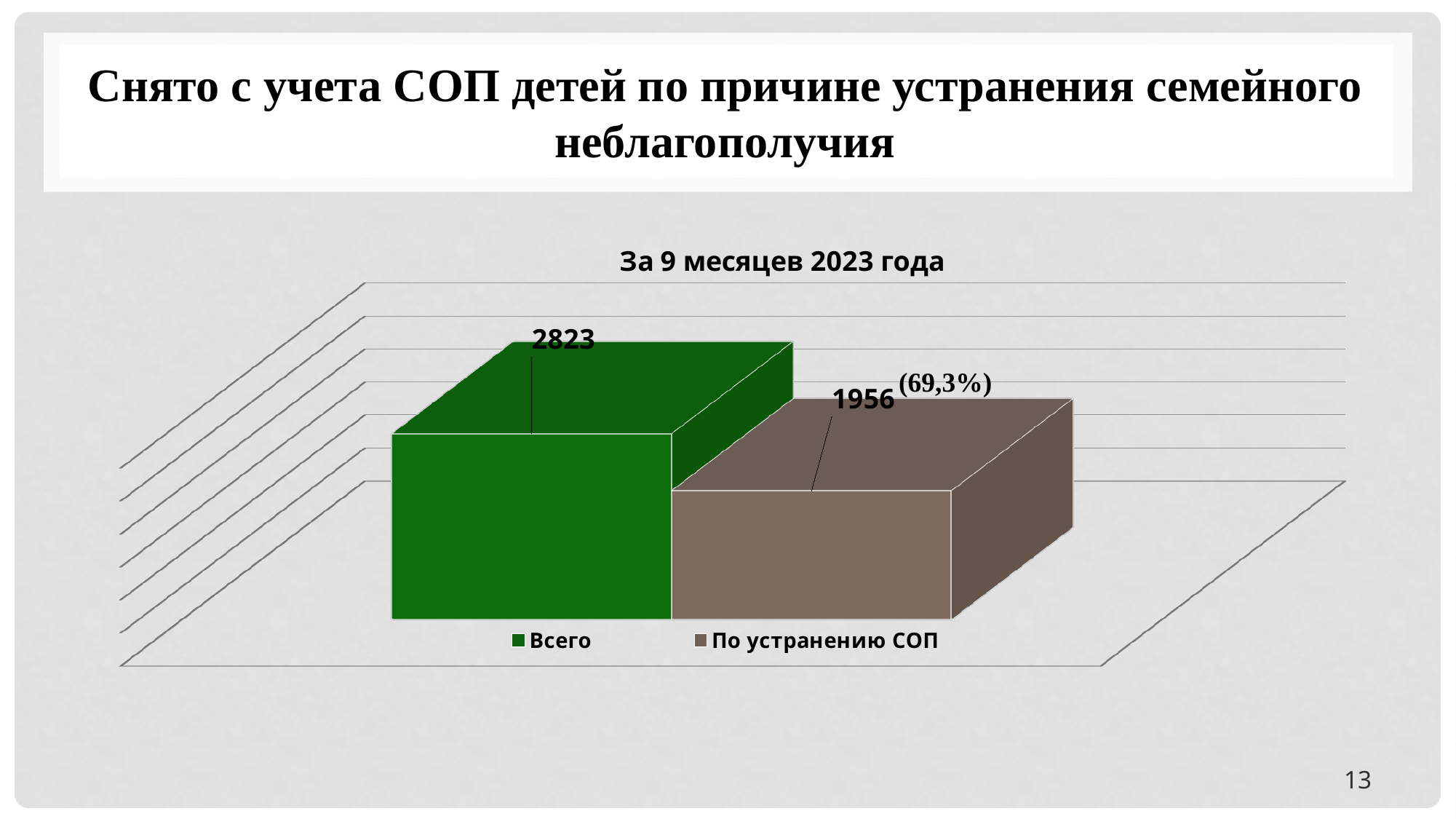
What is the value for "Всего"? 2823 How many bars are plotted in the chart? 2 Which series has the higher value, "Всего" or "По устранению СОП"? Всего What kind of chart is shown on the slide? bar chart What percentage is shown next to the value 1956? (69,3%) What is the difference between the values for "Всего" and "По устранению СОП"? 867 Which series has the lowest value? По устранению СОП How many series does the legend list? 2 What is the value for "По устранению СОП"? 1956 What colour is the bar for "Всего"? green What is the title of the chart? За 9 месяцев 2023 года